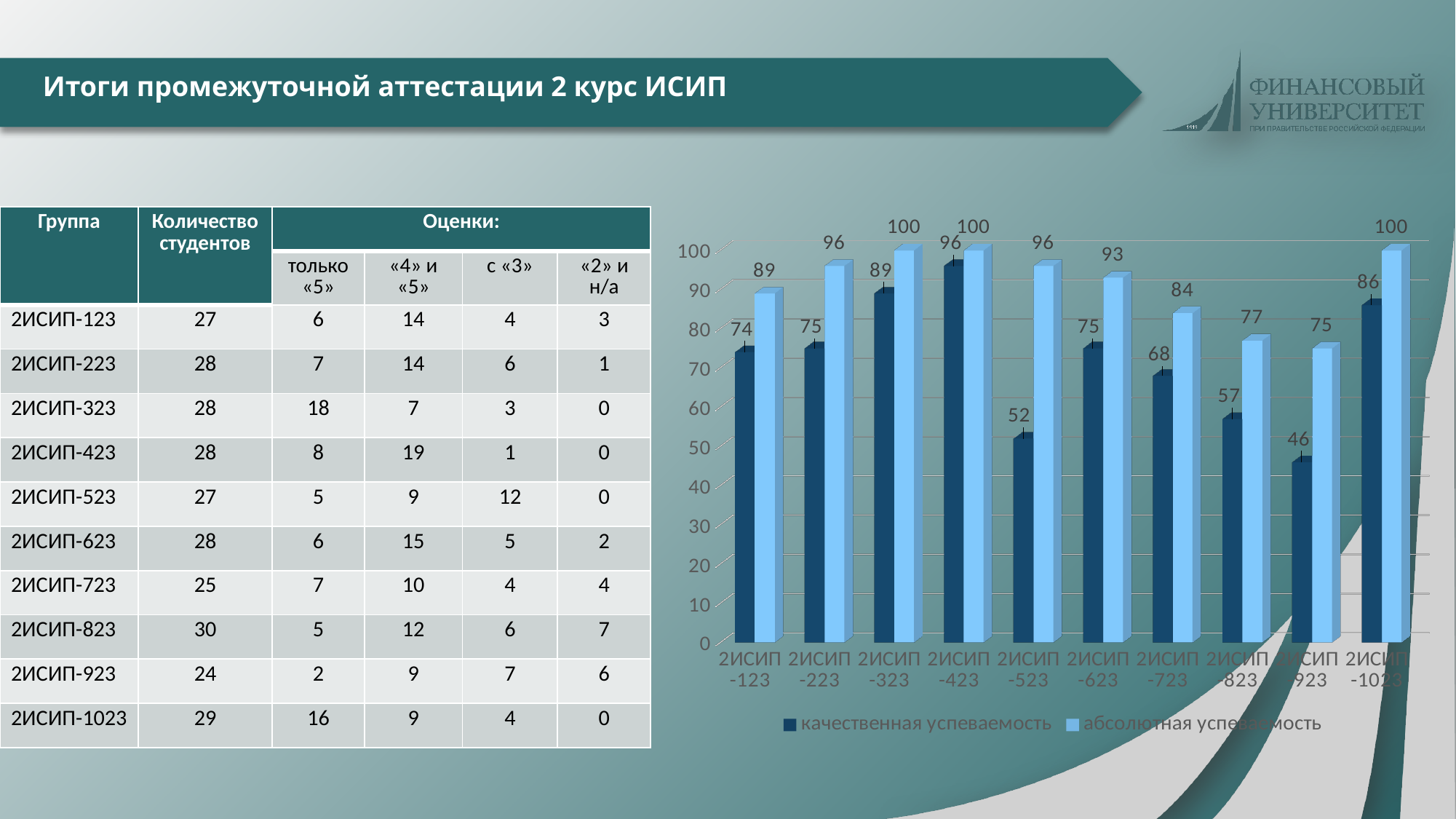
Which series is shown in dark blue in the chart? качественная успеваемость What kind of chart is shown on the slide? Bar chart What is the value of качественная успеваемость for 2ИСИП-1023? 86 How many series does the chart legend list? 2 What is the value of абсолютная успеваемость for 2ИСИП-723? 84 Which group has the highest качественная успеваемость? 2ИСИП-423 What is the difference between абсолютная успеваемость and качественная успеваемость for 2ИСИП-523? 44 What is the value of качественная успеваемость for 2ИСИП-523? 52 Which group has the lowest абсолютная успеваемость? 2ИСИП-923 Which is larger: качественная успеваемость for 2ИСИП-323 or for 2ИСИП-823? 2ИСИП-323 How many groups are shown on the x axis of the chart? 10 Which group has the lowest качественная успеваемость? 2ИСИП-923